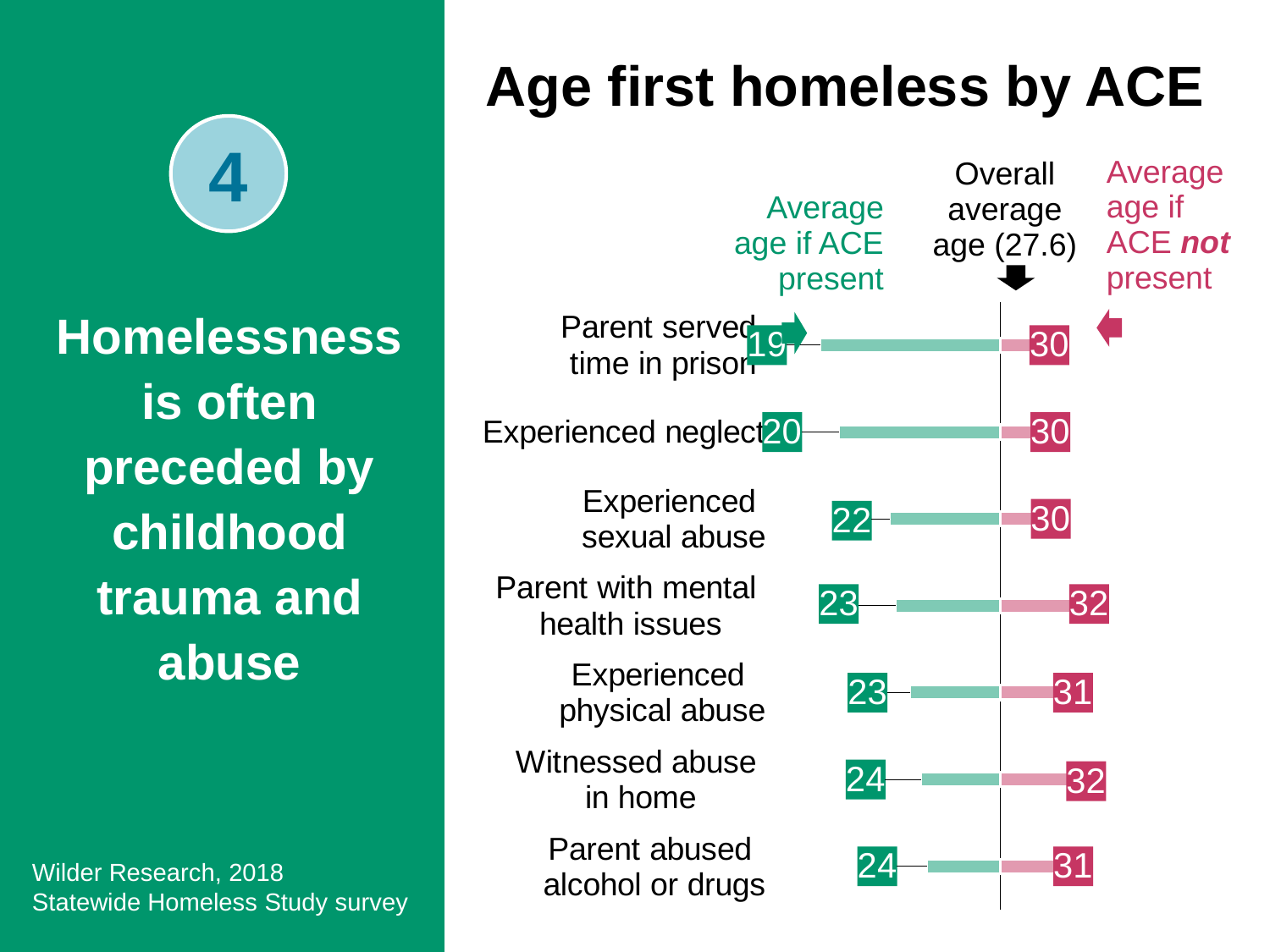
Which ACE category has the lowest average age first homeless if ACE present? Parent served time in prison What is the difference between the average age if ACE not present and if ACE present for 'Parent abused alcohol or drugs'? 7 How many ACE categories are shown on the chart? 7 What is the difference between the average age if ACE not present and if ACE present for 'Parent served time in prison'? 11 What is the average age if ACE present for 'Experienced sexual abuse'? 22 What is the average age first homeless if ACE present for 'Parent served time in prison'? 19 Which is larger for 'Witnessed abuse in home': the average age if ACE present or if ACE not present? Average age if ACE not present Which colour represents the average age if ACE not present? Pink/red What is the overall average age first homeless shown on the chart? 27.6 What is the title of the chart? Age first homeless by ACE What is the average age first homeless if ACE not present for 'Parent with mental health issues'? 32 How many series does the chart show (average age if ACE present and if ACE not present)? 2